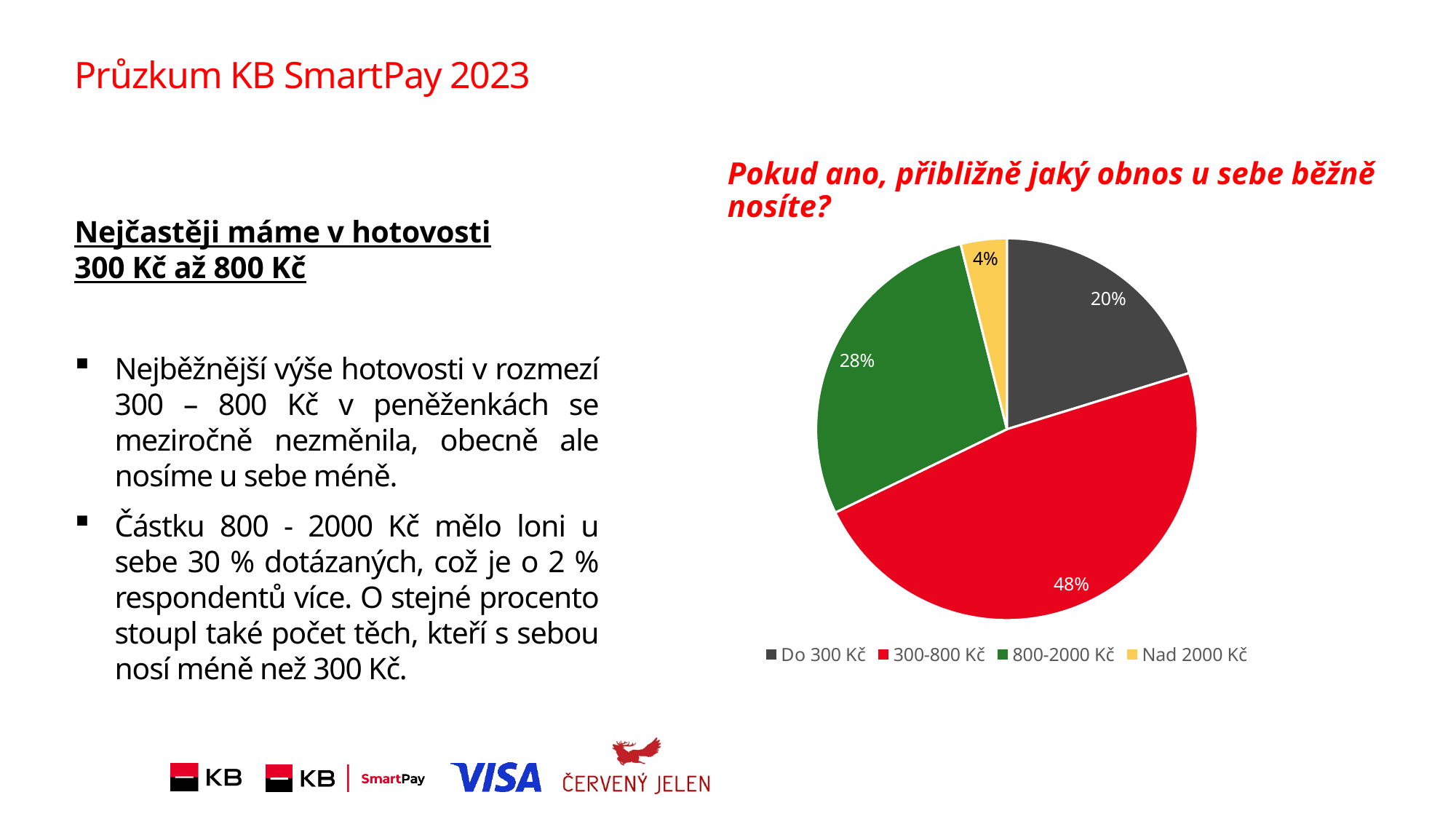
What is the title of the chart? Pokud ano, přibližně jaký obnos u sebe běžně nosíte? What is the value shown for the 800-2000 Kč slice? 28% What is the value shown for the Nad 2000 Kč slice? 4% What kind of chart is shown on the slide? Pie chart What colour is the 300-800 Kč slice in the pie chart? Red What is the difference in percentage points between the 300-800 Kč slice and the 800-2000 Kč slice? 20 What is the value shown for the Do 300 Kč slice? 20% What share of the pie does the 300-800 Kč slice represent? 48% Which is larger, the Do 300 Kč slice or the 800-2000 Kč slice? 800-2000 Kč Which category has the largest slice of the pie? 300-800 Kč Which category has the smallest slice of the pie? Nad 2000 Kč How many categories does the pie chart show? 4